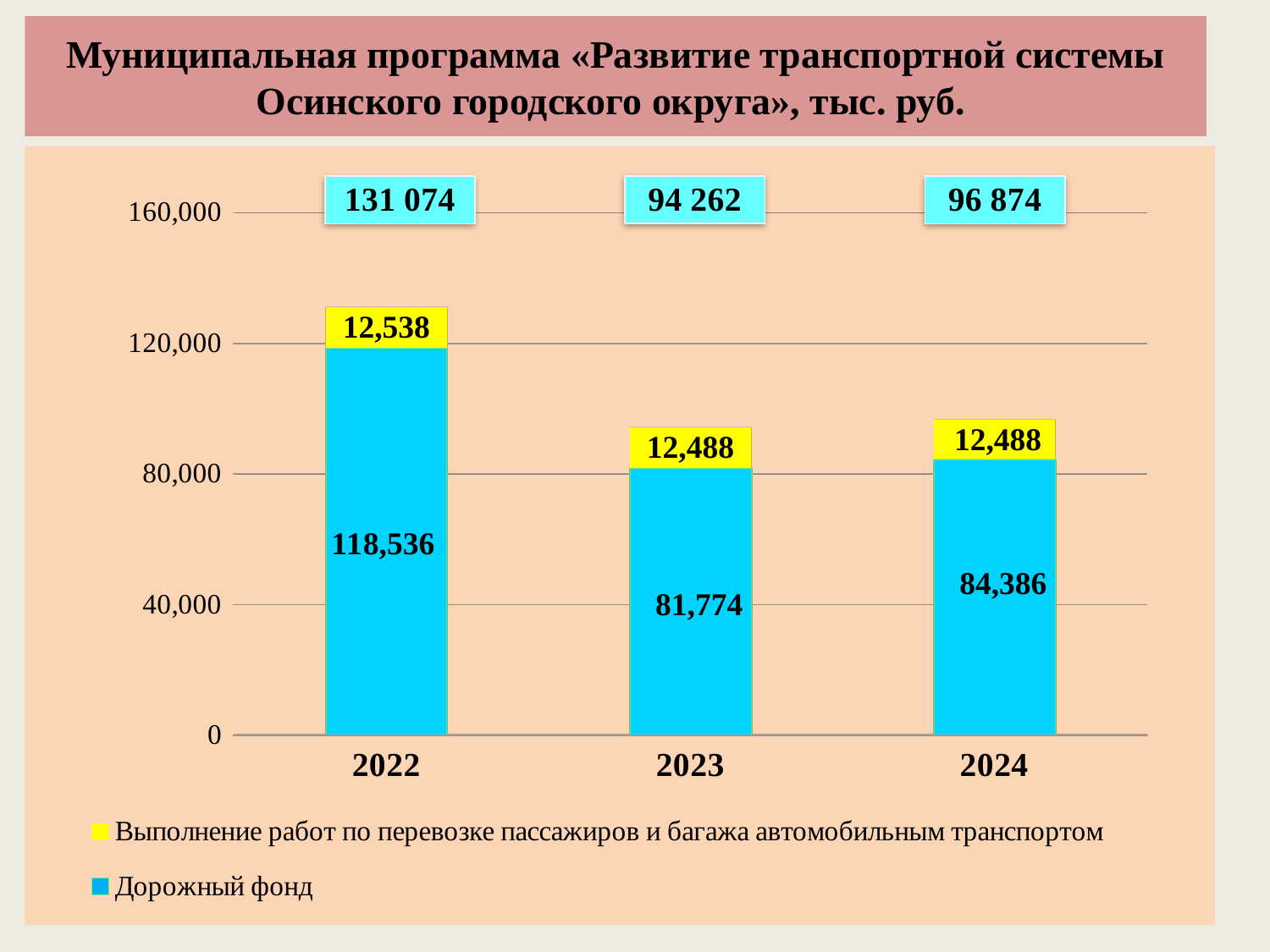
Which year has the highest value for Дорожный фонд? 2022 What is the value for Выполнение работ по перевозке пассажиров и багажа автомобильным транспортом in 2022? 12,538 What is the value for Выполнение работ по перевозке пассажиров и багажа автомобильным транспортом in 2024? 12,488 What is the value for Дорожный фонд in 2023? 81,774 What kind of chart is shown on the slide? Stacked bar chart What is the value for Дорожный фонд in 2022? 118,536 What is the total of the stacked bar for 2022? 131 074 What is the difference between the Дорожный фонд values for 2024 and 2023? 2,612 Is the Дорожный фонд value for 2023 greater or less than 80,000? greater How many series does the legend list? 2 Which year has the lowest total? 2023 What is the total of the stacked bar for 2024? 96 874